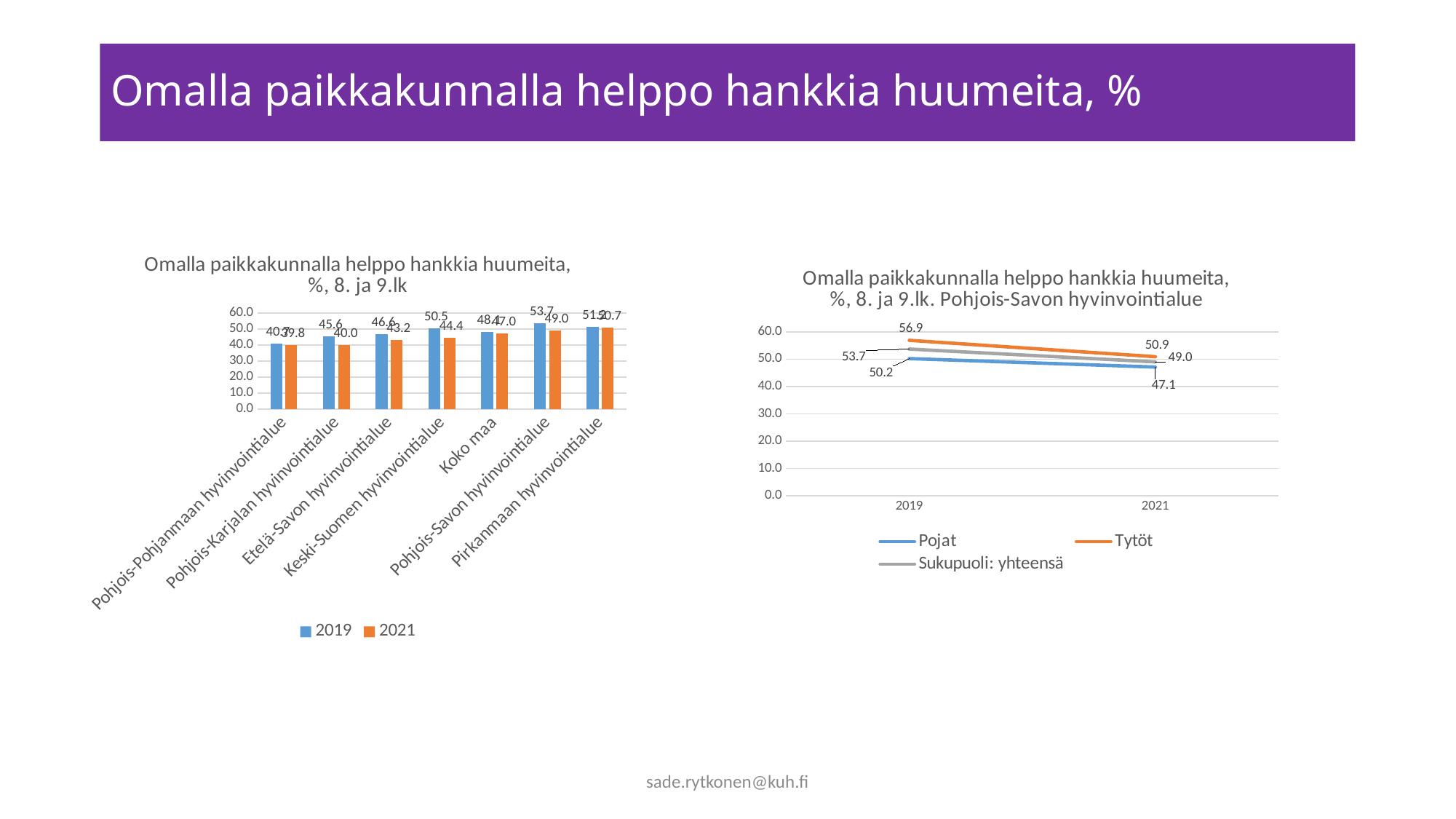
In the left bar chart, what is the 2021 value for Keski-Suomen hyvinvointialue? 44.4 What kind of chart is the chart on the left? bar chart In the right line chart, what is the value for Pojat in 2021? 47.1 In the right line chart, what is the value for Tytöt in 2019? 56.9 In the left bar chart, for Etelä-Savon hyvinvointialue, which year has the larger value, 2019 or 2021? 2019 In the right line chart, what is the difference between the Tytöt values for 2019 and 2021? 6.0 In the left bar chart, what is the 2019 value for Pohjois-Savon hyvinvointialue? 53.7 In the right line chart, do the values rise or fall from 2019 to 2021? fall How many categories are shown on the x axis of the left bar chart? 7 In the left bar chart, what is the difference between the 2019 and 2021 values for Pohjois-Karjalan hyvinvointialue? 5.6 How many series does the legend of the left chart list? 2 In the left bar chart, which category has the lowest 2019 value? Pohjois-Pohjanmaan hyvinvointialue